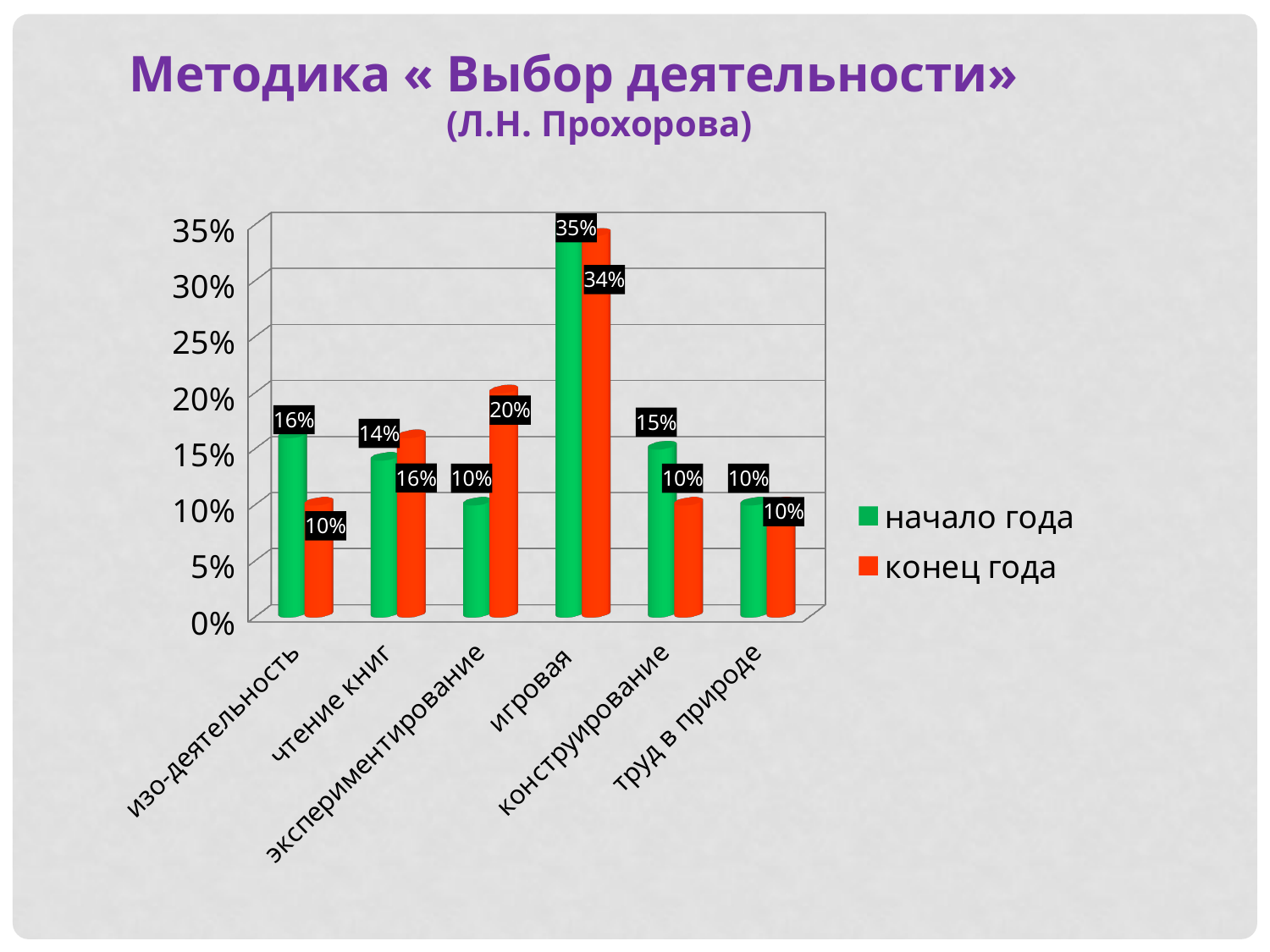
Which category has the highest value in the «начало года» series? игровая What is the value for «игровая» in the «конец года» series? 34% What is the value for «экспериментирование» in the «конец года» series? 20% Which colour represents the «конец года» series in the legend? red For «чтение книг», which is larger: the «начало года» value or the «конец года» value? конец года What kind of chart is shown on the slide? bar chart What is the value for «конструирование» in the «начало года» series? 15% How many categories are shown on the x axis? 6 How many series does the legend list? 2 Which category has the lowest value in the «конец года» series? изо-деятельность, конструирование and труд в природе (all 10%) What is the difference between the «конец года» and «начало года» values for «экспериментирование»? 10% What is the value for «изо-деятельность» in the «начало года» series? 16%